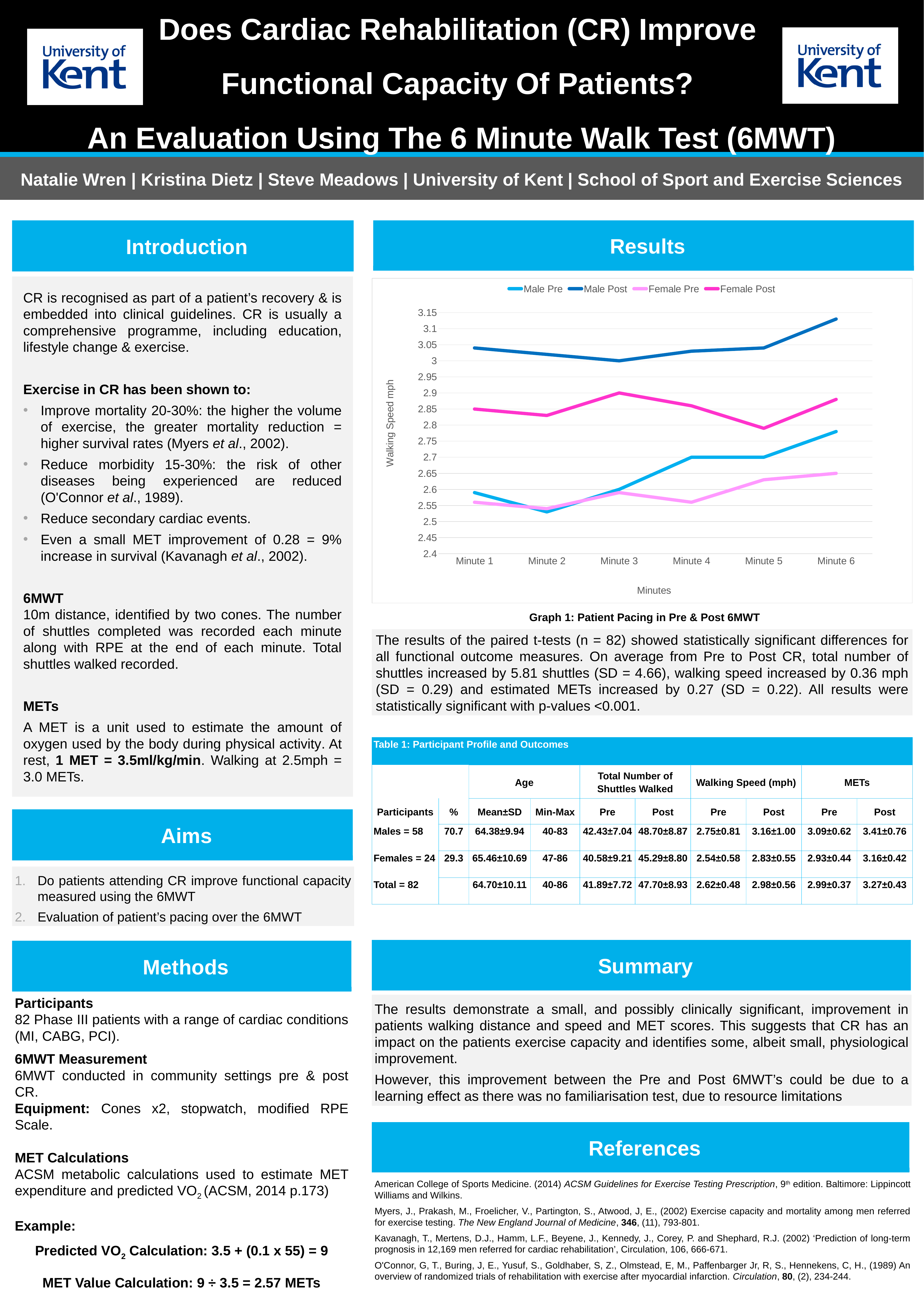
At Minute 1, which is higher: the Female Post or the Male Pre walking speed? Female Post Is the Male Pre walking speed at Minute 2 greater or less than 2.6 mph? less Which series has the highest walking speed across all minutes in the Results chart? Male Post Is the Male Post walking speed at Minute 6 greater or less than 3.1 mph? greater How many minute categories are plotted along the x axis of the Results chart? 6 What kind of chart is shown in the Results section? line chart Does the Male Pre walking speed rise or fall from Minute 3 to Minute 6? rise Is the Female Pre walking speed at Minute 4 greater or less than 2.6 mph? less What is the y-axis title of the Results chart? Walking Speed mph How many series does the legend of the Results chart list? 4 At which minute is the Male Pre walking speed lowest? Minute 2 At which minute does the Male Post series reach its highest walking speed? Minute 6